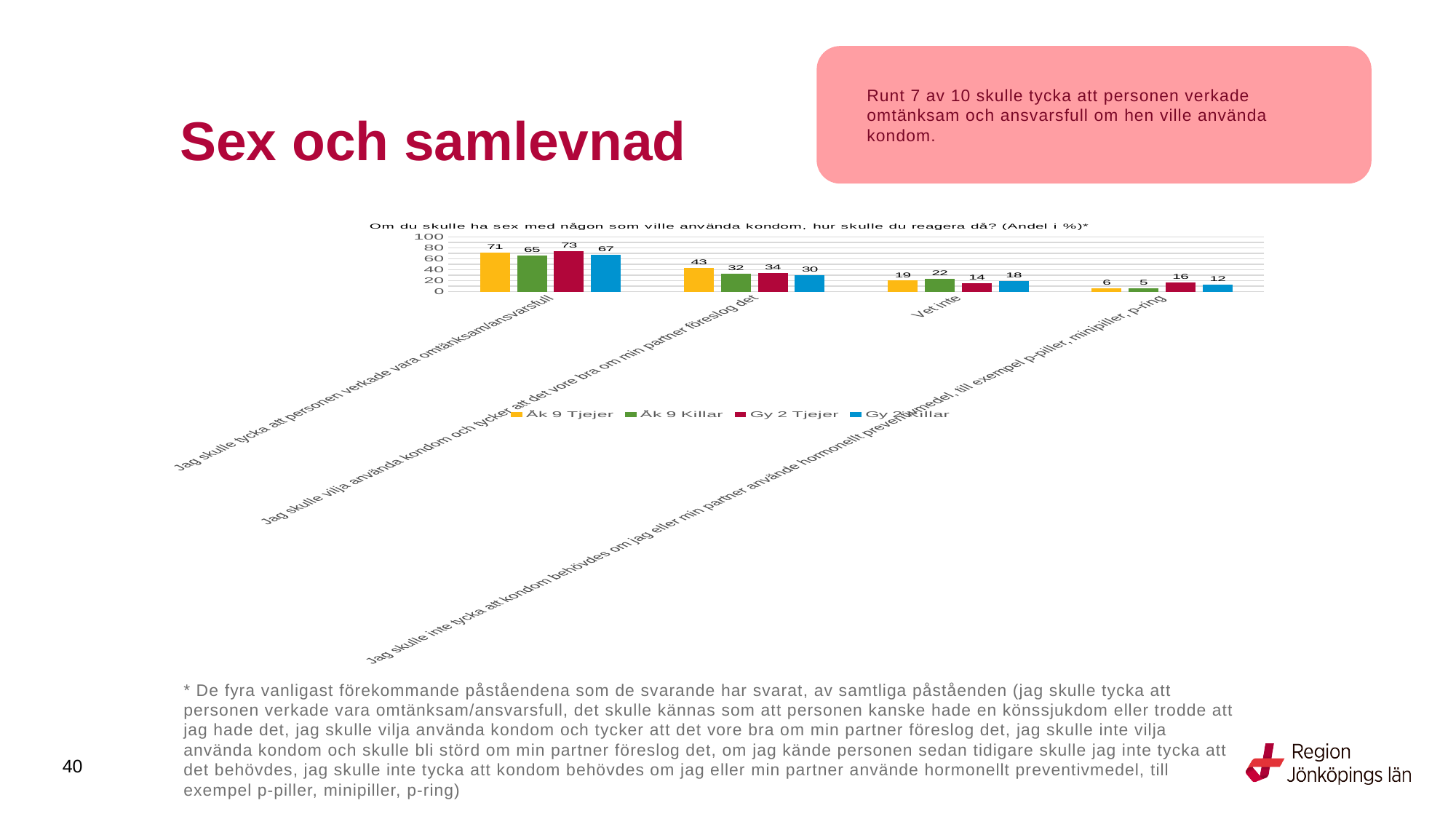
How many categories are shown on the x axis of the chart? 4 What is the difference between the Åk 9 Tjejer and Åk 9 Killar values in the category "Jag skulle vilja använda kondom och tycker att det vore bra om min partner föreslog det"? 11 Is the value for Gy 2 Tjejer in the category "Jag skulle tycka att personen verkade vara omtänksam/ansvarsfull" greater or less than 60? greater Which series has the lowest value in the category "Jag skulle inte tycka att kondom behövdes om jag eller min partner använde hormonellt preventivmedel, till exempel p-piller, minipiller, p-ring"? Åk 9 Killar What value is shown for Gy 2 Killar in the category "Jag skulle vilja använda kondom och tycker att det vore bra om min partner föreslog det"? 30 What value is shown for Åk 9 Tjejer in the category "Jag skulle tycka att personen verkade vara omtänksam/ansvarsfull"? 71 What value is shown for Gy 2 Tjejer in the category "Vet inte"? 14 What kind of chart is shown on the slide? Bar chart Which colour represents Gy 2 Tjejer in the chart? Red In the category "Vet inte", which is larger: the value for Åk 9 Killar or the value for Gy 2 Killar? Åk 9 Killar Which series has the highest value in the category "Jag skulle tycka att personen verkade vara omtänksam/ansvarsfull"? Gy 2 Tjejer How many series does the legend list? 4